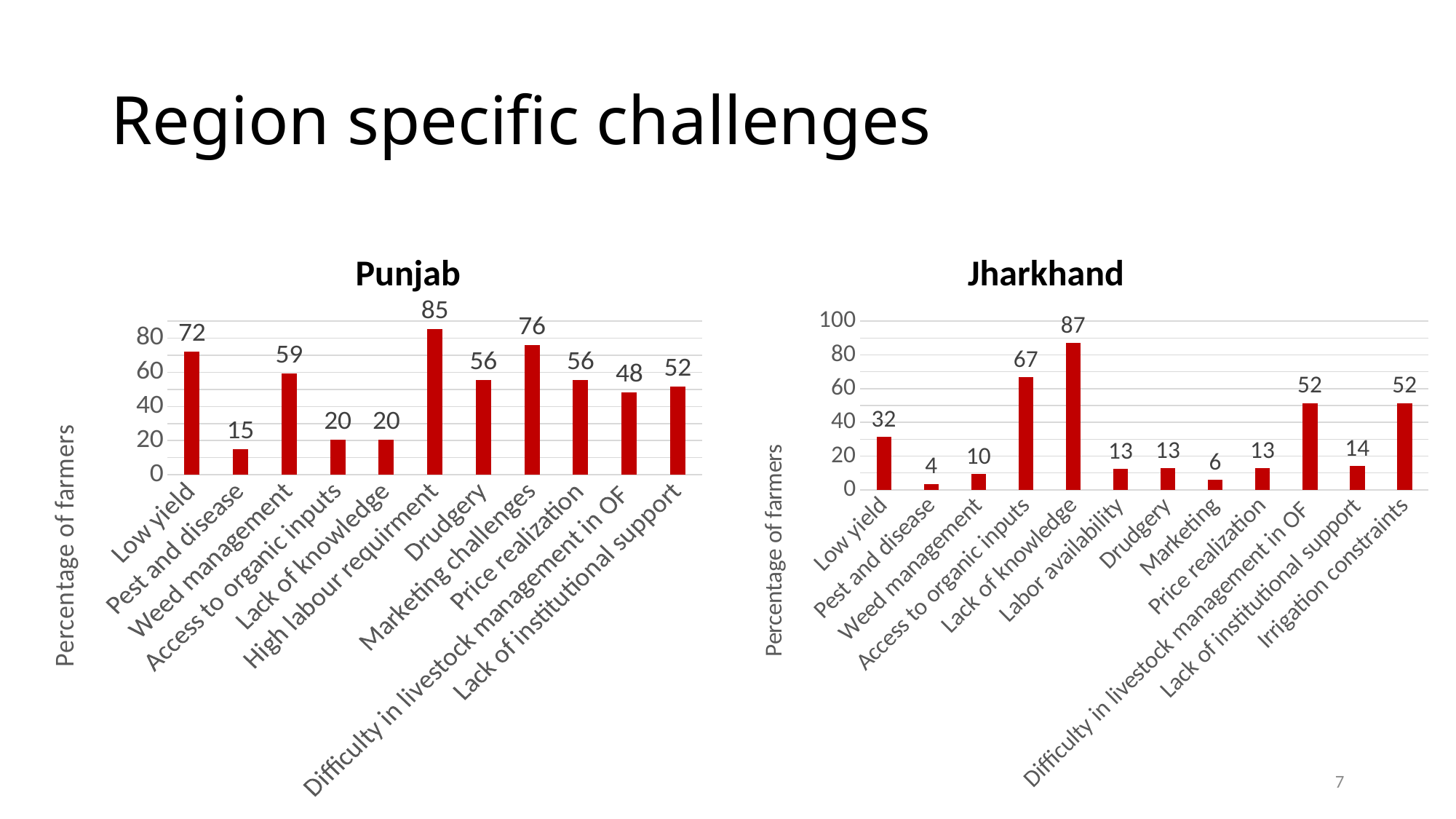
What is the y-axis label of the Punjab chart? Percentage of farmers In the Jharkhand chart, what is the difference between the values for Lack of knowledge and Irrigation constraints? 35 In the Jharkhand chart, which category has the lowest value? Pest and disease In the Punjab chart, what is the value for High labour requirment? 85 How many categories does the Punjab chart show? 11 What kind of chart is the Jharkhand chart? Bar chart In the Jharkhand chart, which category has the highest value? Lack of knowledge In the Jharkhand chart, which is larger, the value for Low yield or the value for Access to organic inputs? Access to organic inputs In the Punjab chart, which category has the lowest value? Pest and disease In the Punjab chart, what is the difference between the values for Low yield and Pest and disease? 57 How many categories does the Jharkhand chart show? 12 In the Jharkhand chart, what is the value for Lack of knowledge? 87